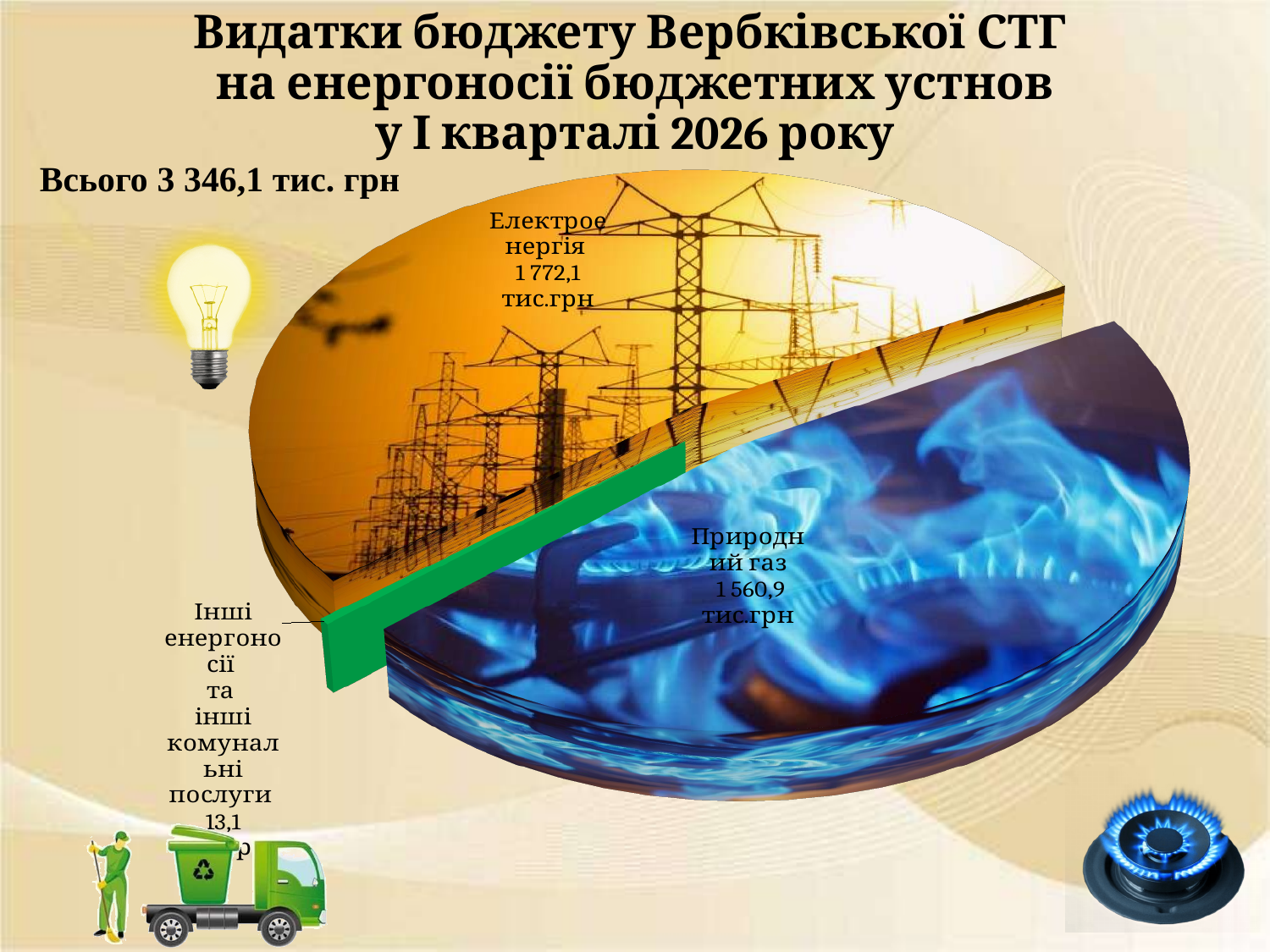
Which slice of the pie is shown in green? Інші енергоносії та інші комунальні послуги What is the value shown for Інші енергоносії та інші комунальні послуги? 13,1 What is the difference between the values for Електроенергія and Природний газ? 211,2 тис.грн What kind of chart is shown on the slide? pie chart What is the value shown for Природний газ? 1 560,9 тис.грн What is the value shown for Електроенергія? 1 772,1 тис.грн How many slices does the pie chart have? 3 Which is larger, the value for Електроенергія or the value for Природний газ? Електроенергія Which category has the smallest slice of the pie? Інші енергоносії та інші комунальні послуги Which category has the largest slice of the pie? Електроенергія What total amount is stated on the slide for all expenditures? 3 346,1 тис. грн Which quarter and year does the chart title refer to? І квартал 2026 року